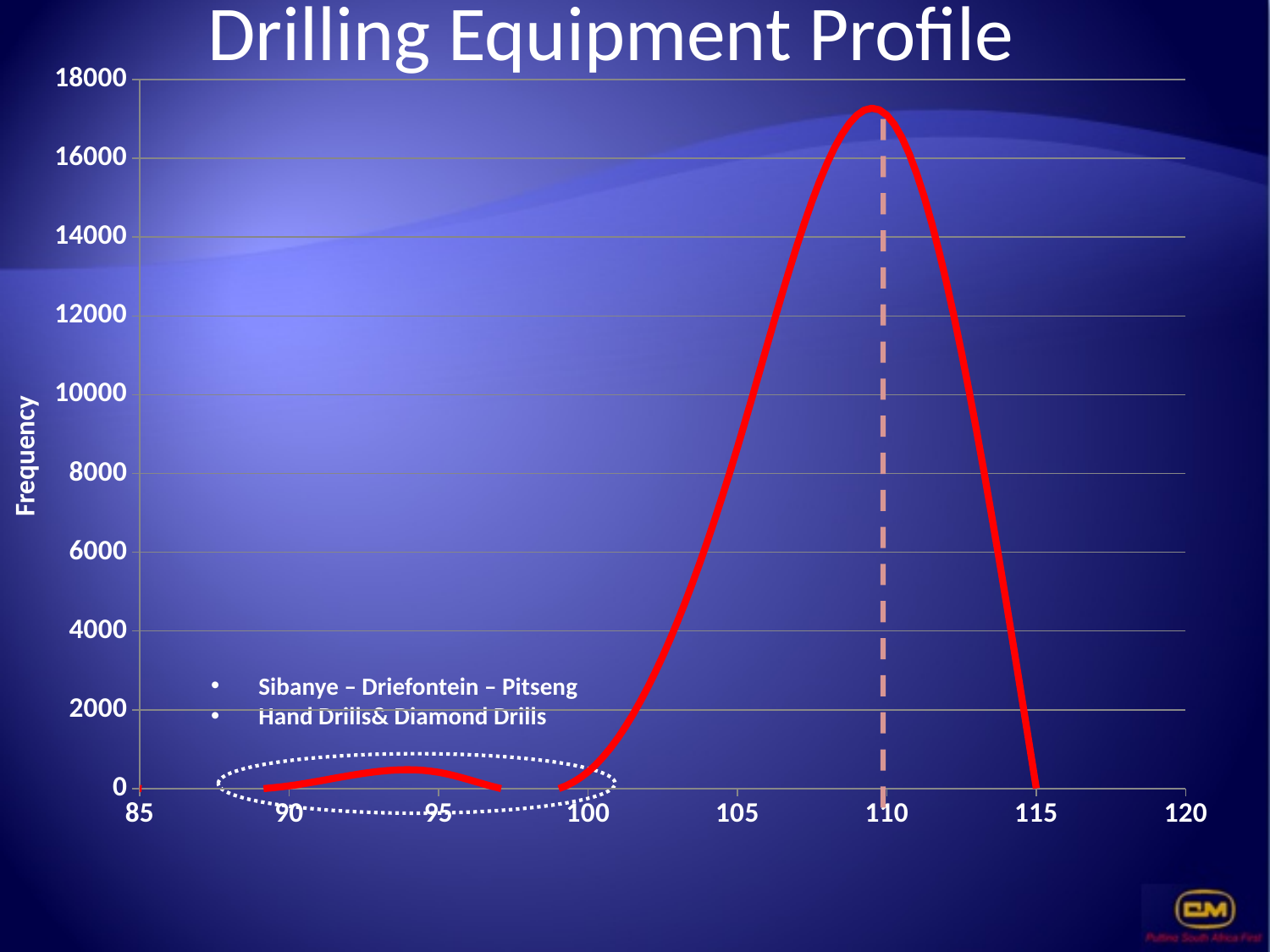
What is the label on the vertical axis of the chart? Frequency Is the value of the red curve at x = 115 greater or less than 2000? less Is the value of the red curve at x = 100 greater or less than 2000? less Is the value of the red curve at x = 105 greater or less than 10000? less What is the title of the chart? Drilling Equipment Profile Between x = 110 and x = 115, does the red curve rise or fall? fall What is the highest value shown on the vertical axis? 18000 What kind of chart is shown on the slide? Line chart How many tick labels are shown on the horizontal axis? 8 Near which x-axis value does the red curve reach its highest point? 110 Between x = 100 and x = 110, does the red curve rise or fall? rise